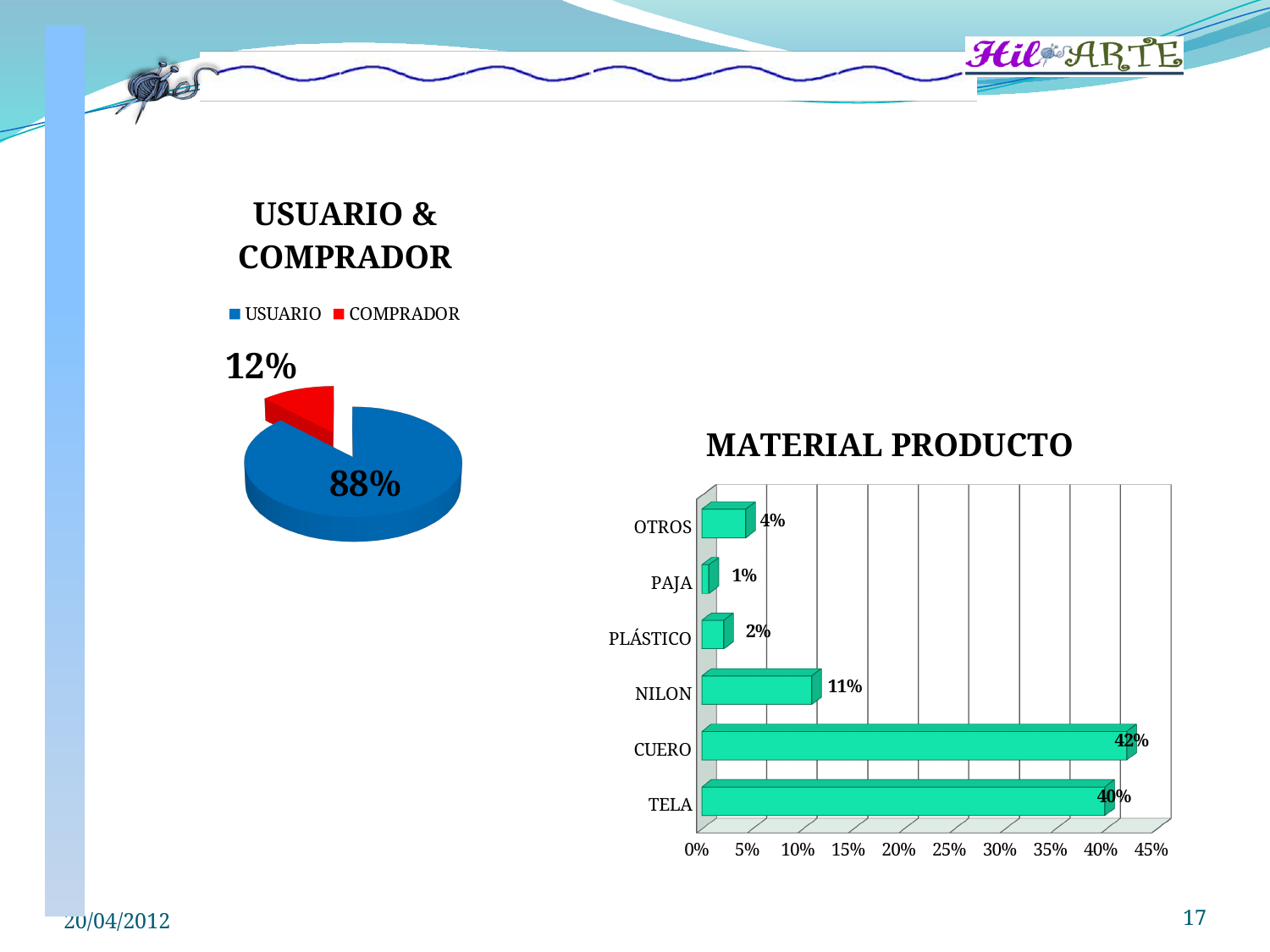
How many categories are shown in the MATERIAL PRODUCTO chart? 6 In the MATERIAL PRODUCTO chart, what is the value for NILON? 11% How many series does the legend of the USUARIO & COMPRADOR chart list? 2 In the USUARIO & COMPRADOR chart, what share of the pie is COMPRADOR? 12% What kind of chart is the USUARIO & COMPRADOR chart? Pie chart In the USUARIO & COMPRADOR chart, what share of the pie is USUARIO? 88% In the MATERIAL PRODUCTO chart, what is the value for CUERO? 42% In the MATERIAL PRODUCTO chart, which material has the lowest value? PAJA In the MATERIAL PRODUCTO chart, which is larger, the value for OTROS or the value for PLÁSTICO? OTROS In the MATERIAL PRODUCTO chart, which material has the highest value? CUERO In the MATERIAL PRODUCTO chart, what is the difference between the values for CUERO and TELA? 2% What kind of chart is the MATERIAL PRODUCTO chart? Bar chart